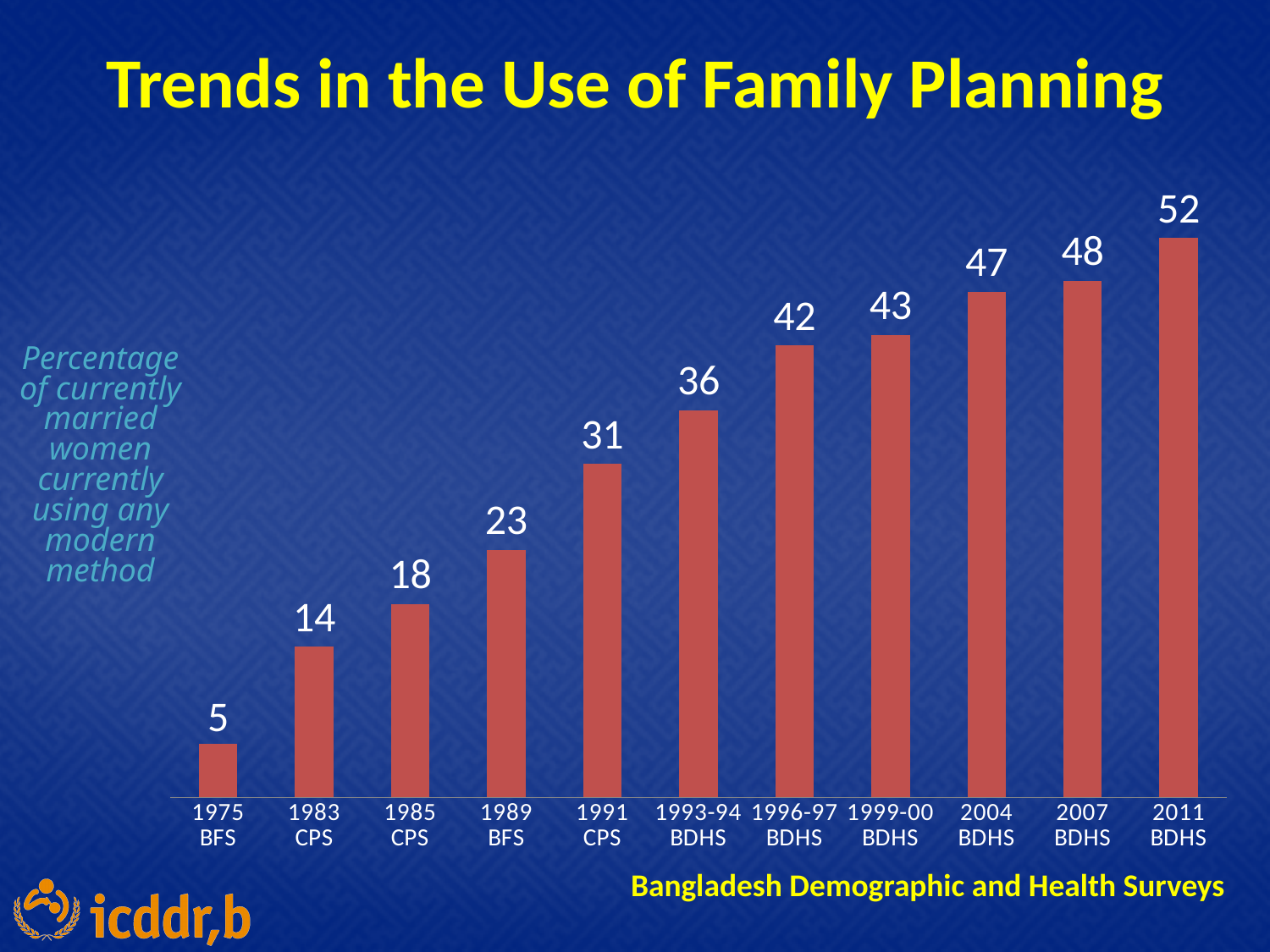
What is the value for 2004 BDHS? 47 Do the values rise or fall from 1975 to 2011? Rise What is the value for 1975 BFS? 5 Which is larger, the value for 1996-97 BDHS or the value for 1999-00 BDHS? 1999-00 BDHS Which survey has the lowest value? 1975 BFS What is the value for 1993-94 BDHS? 36 Which survey has the highest value? 2011 BDHS What is the title of the chart? Trends in the Use of Family Planning What is the difference between the values for 2011 BDHS and 1975 BFS? 47 What kind of chart is shown on the slide? Bar chart How many surveys (bars) are shown in the chart? 11 What is the difference between the values for 1991 CPS and 1989 BFS? 8